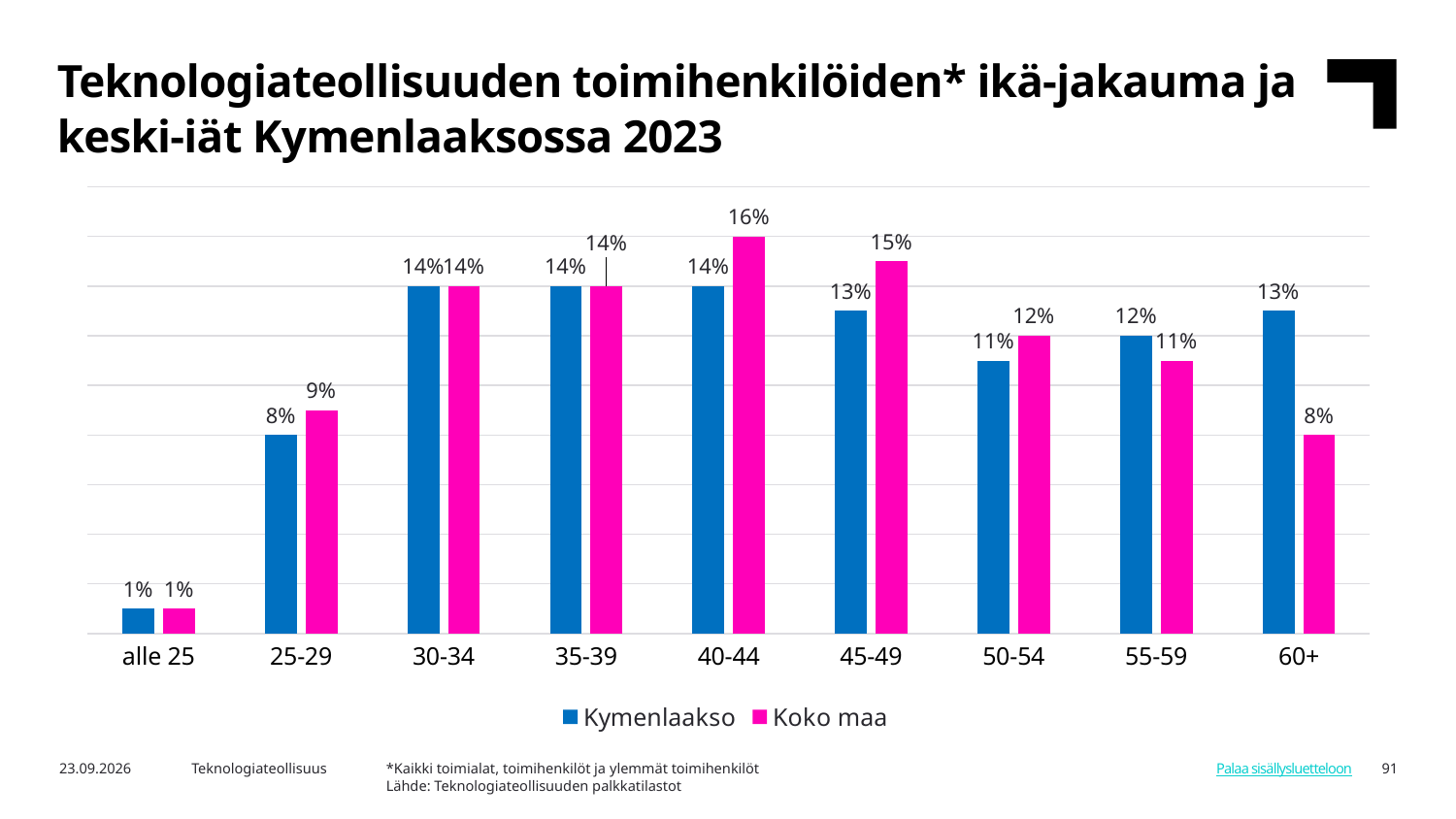
Which age group has the lowest value for Kymenlaakso? alle 25 Which age group has the highest value for Koko maa? 40-44 In the 55-59 age group, which series has the larger value, Kymenlaakso or Koko maa? Kymenlaakso In the 45-49 age group, which series has the larger value, Kymenlaakso or Koko maa? Koko maa What is the value for Koko maa in the 45-49 age group? 15% What is the value for Kymenlaakso in the 60+ age group? 13% What is the difference between Koko maa and Kymenlaakso in the 60+ age group? 5% How many series does the legend list? 2 What kind of chart is shown on the slide? Bar chart What is the difference between Koko maa and Kymenlaakso in the 40-44 age group? 2% How many age groups are shown on the x axis? 9 What is the value for Kymenlaakso in the 25-29 age group? 8%